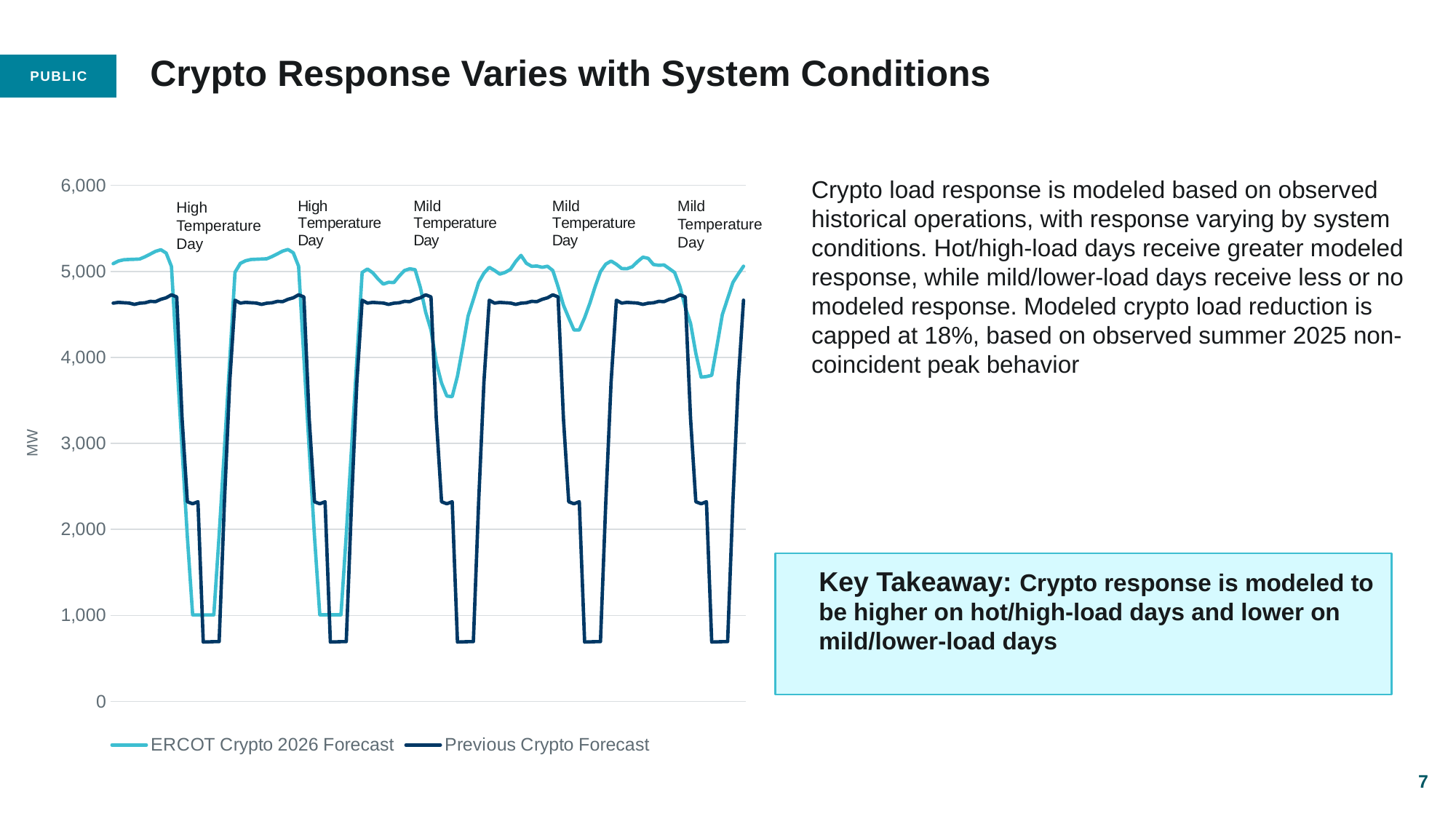
How many series does the chart legend list? 2 Is the peak value of the Previous Crypto Forecast line greater or less than 5,000? less What unit is shown on the chart's vertical axis label? MW How many annotated days are shown across the chart in total? 5 On the Mild Temperature Days, is the lowest value of the ERCOT Crypto 2026 Forecast line greater or less than 3,000? greater How many days are annotated as 'High Temperature Day' on the chart? 2 What kind of chart is shown on the slide? Line chart What are the two series named in the chart legend? ERCOT Crypto 2026 Forecast and Previous Crypto Forecast Is the peak value of the ERCOT Crypto 2026 Forecast line greater or less than 5,000? greater On the High Temperature Days, which series drops to a lower minimum value: ERCOT Crypto 2026 Forecast or Previous Crypto Forecast? Previous Crypto Forecast How many days are annotated as 'Mild Temperature Day' on the chart? 3